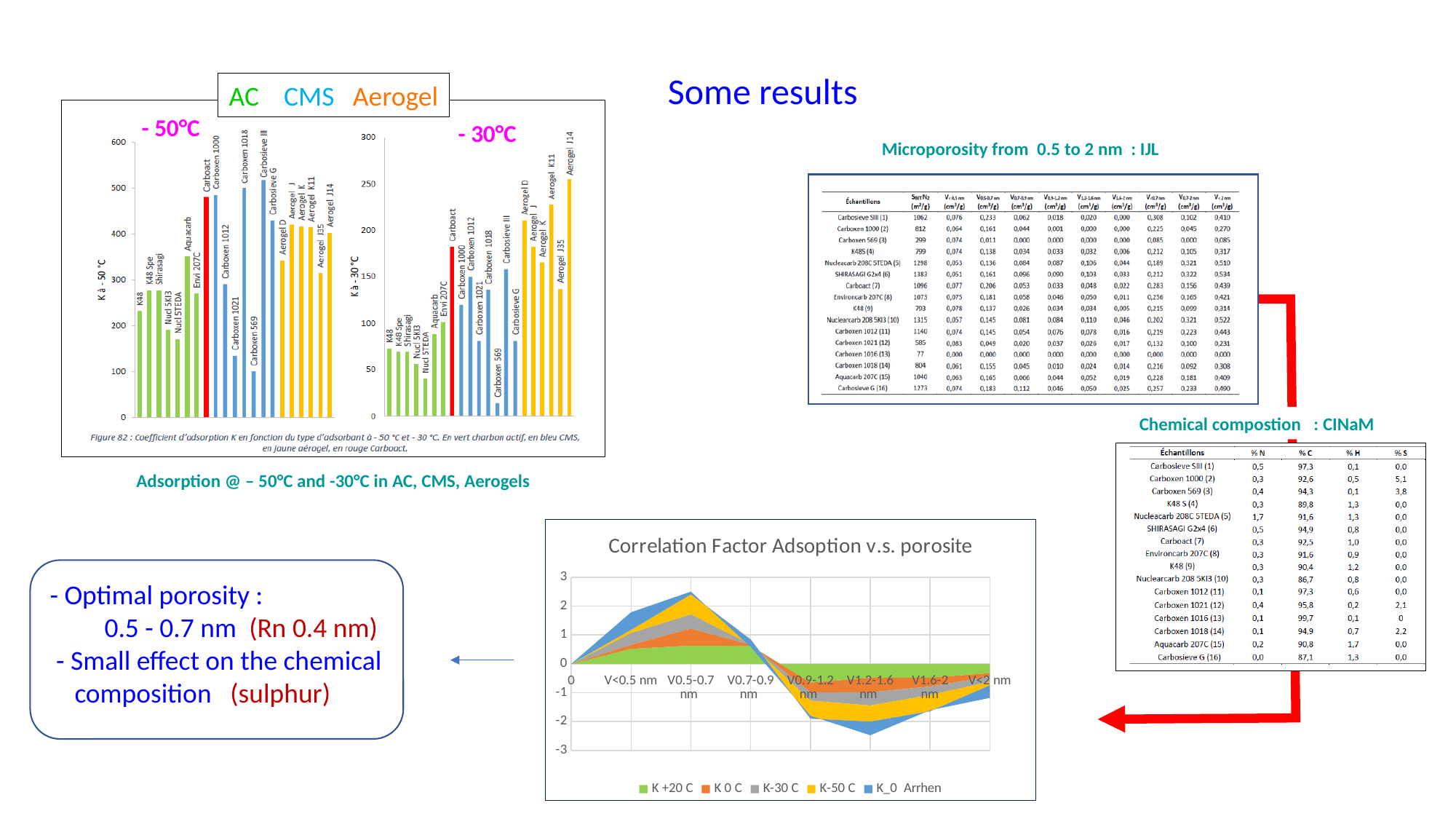
In the -30°C bar chart on the left, which adsorbent has the highest value? Aerogel J14 In the -30°C bar chart on the left, is the value for Carboact greater or less than 150? greater How many series does the legend of the 'Correlation Factor Adsoption v.s. porosite' chart list? 5 What kind of chart is the 'Correlation Factor Adsoption v.s. porosite' chart? area chart What kind of chart is the -50°C chart on the left of the slide? bar chart What is the highest value shown on the y axis of the 'Correlation Factor Adsoption v.s. porosite' chart? 3 In the 'Correlation Factor Adsoption v.s. porosite' chart, do the values rise or fall from V0.5-0.7 nm to V1.2-1.6 nm? fall In the -50°C bar chart on the left, which is larger, the value for Carboact or the value for K48? Carboact In the -50°C bar chart on the left, is the value for Carboact greater or less than 400? greater In the 'Correlation Factor Adsoption v.s. porosite' chart, which series is shown in blue? K_0 Arrhen